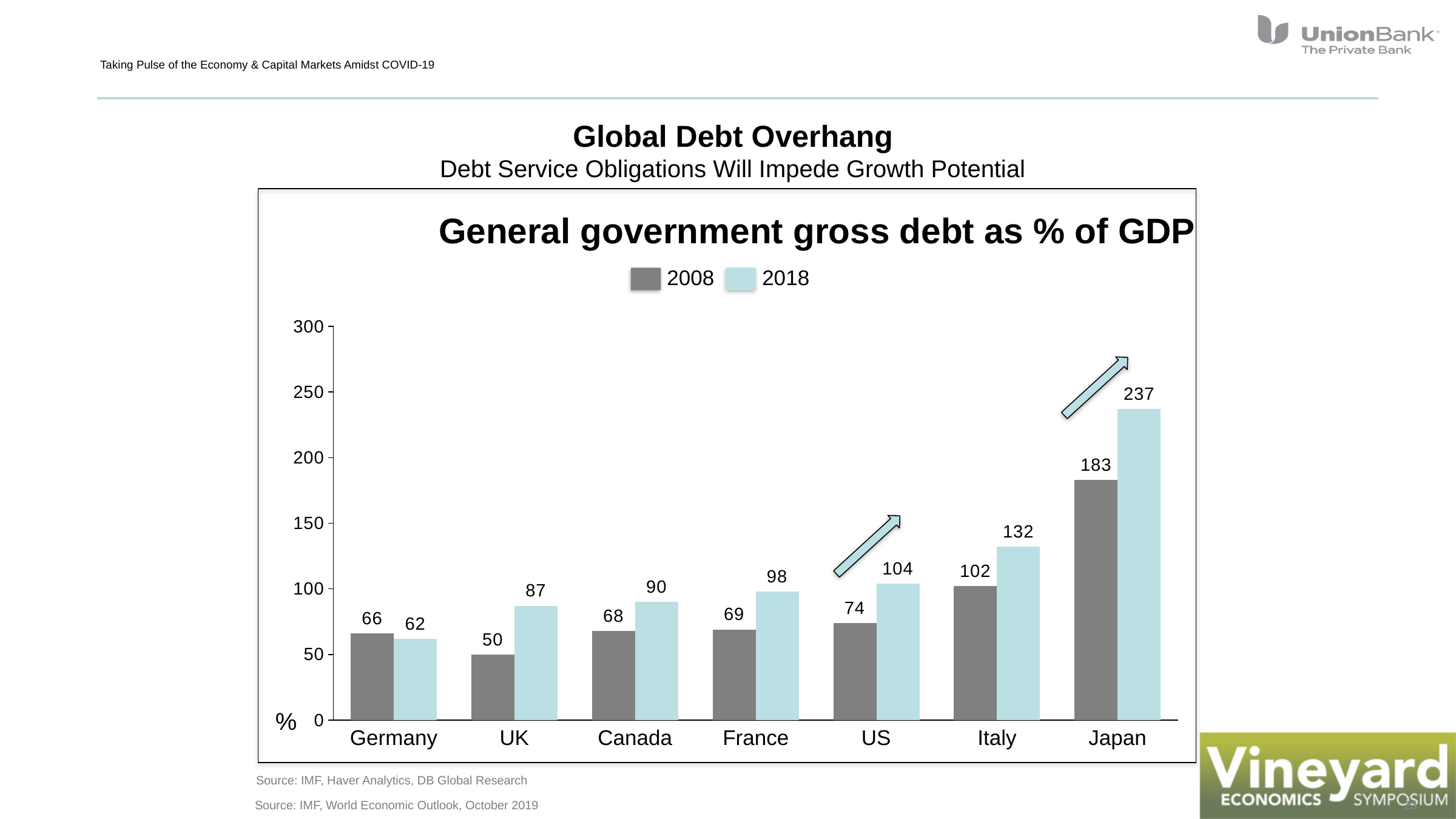
Which is larger for Germany, the 2008 value or the 2018 value? 2008 How many series does the legend list? 2 What is the 2008 value for the UK? 50 What is the title of the chart? General government gross debt as % of GDP What is the difference between the 2018 and 2008 values for Japan? 54 Which country has the highest 2018 value? Japan Which country has the lowest 2008 value? UK How many countries are shown on the x axis? 7 What is the difference between the 2018 and 2008 values for the US? 30 What kind of chart is shown? Bar chart What is the 2018 value for Japan? 237 What is the 2018 value for France? 98